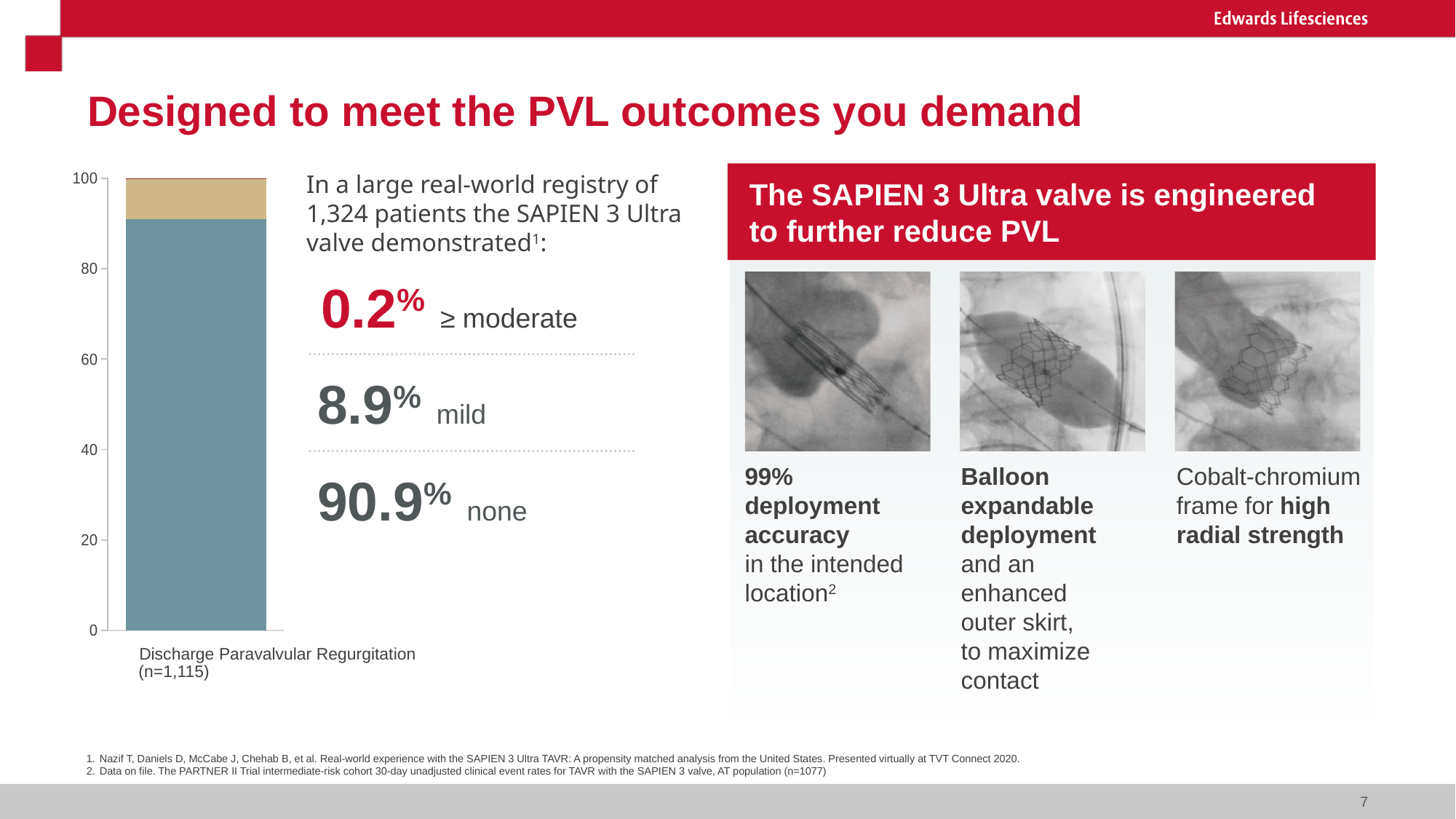
What is the difference between the percentage with no regurgitation and the percentage with mild regurgitation? 82.0% How many categories are plotted on the x axis of the bar chart? 1 What percentage of patients had ≥ moderate paravalvular regurgitation at discharge? 0.2% What is the maximum value shown on the y axis of the chart? 100 What kind of chart is shown on the slide? Stacked bar chart Which regurgitation grade accounts for the smallest share of the bar? ≥ moderate What percentage of patients had mild paravalvular regurgitation at discharge? 8.9% What is the category label under the bar in the chart? Discharge Paravalvular Regurgitation (n=1,115) Which is larger, the percentage with mild regurgitation or the percentage with ≥ moderate regurgitation? mild Is the top of the 'none' segment of the bar greater or less than 80 on the y axis? greater What percentage of patients had no paravalvular regurgitation at discharge? 90.9% Which regurgitation grade accounts for the largest share of the bar? none